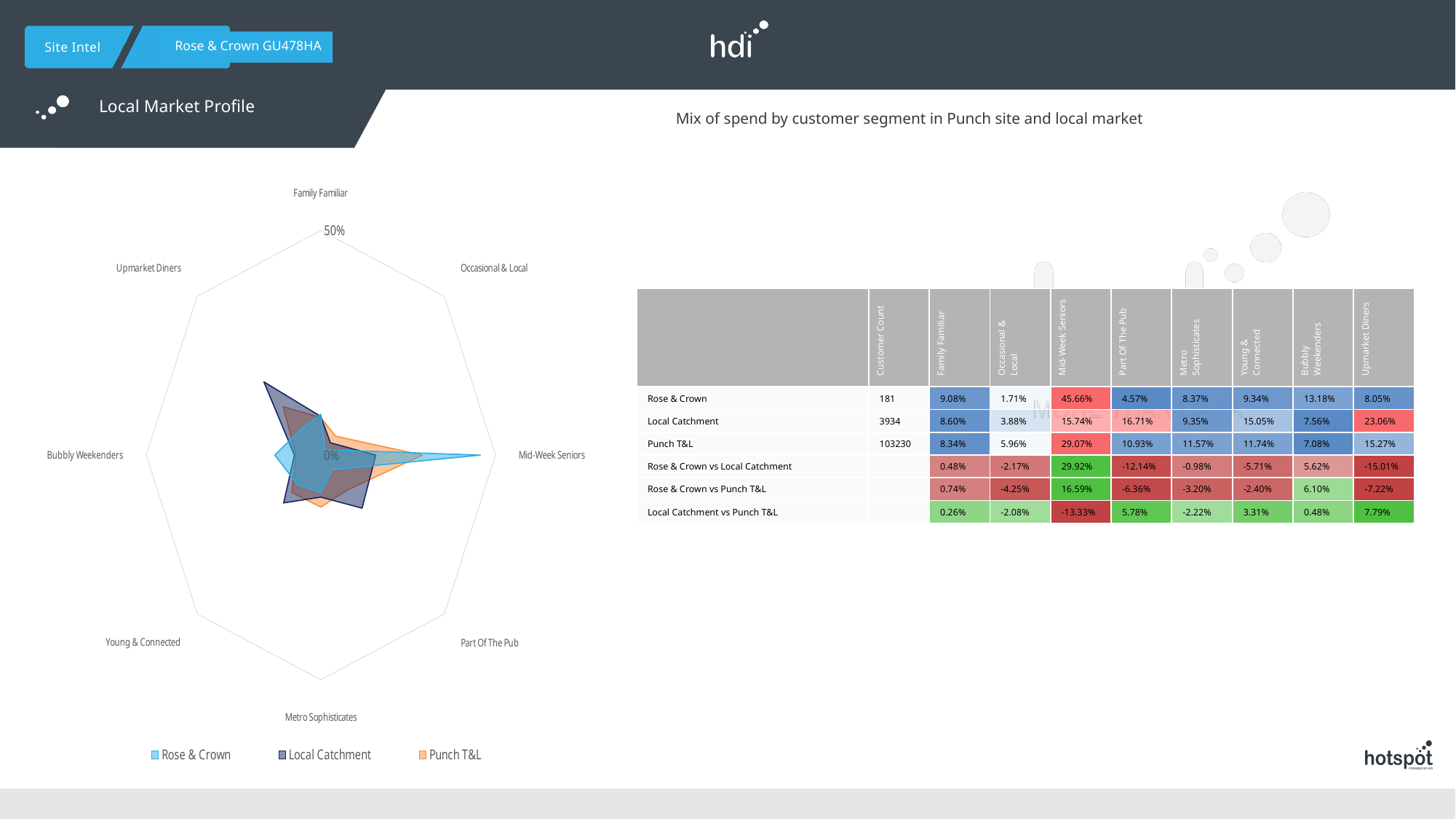
Which segment has the highest value for Local Catchment? Upmarket Diners What is the Rose & Crown value for Mid-Week Seniors? 45.66% How many customer segment categories are plotted on the radar chart? 8 What is the outermost axis value labelled on the radar chart? 50% What kind of chart is shown on the left of the slide? Radar chart For Mid-Week Seniors, which is larger: Rose & Crown or Punch T&L? Rose & Crown Is the Local Catchment value for Upmarket Diners greater or less than 50%? less What is the difference between the Rose & Crown and Local Catchment values for Mid-Week Seniors? 29.92% What is the Local Catchment value for Upmarket Diners? 23.06% How many series does the radar chart's legend list? 3 On the radar chart, which customer segment has the lowest value for Rose & Crown? Occasional & Local On the radar chart, which customer segment has the highest value for Rose & Crown? Mid-Week Seniors